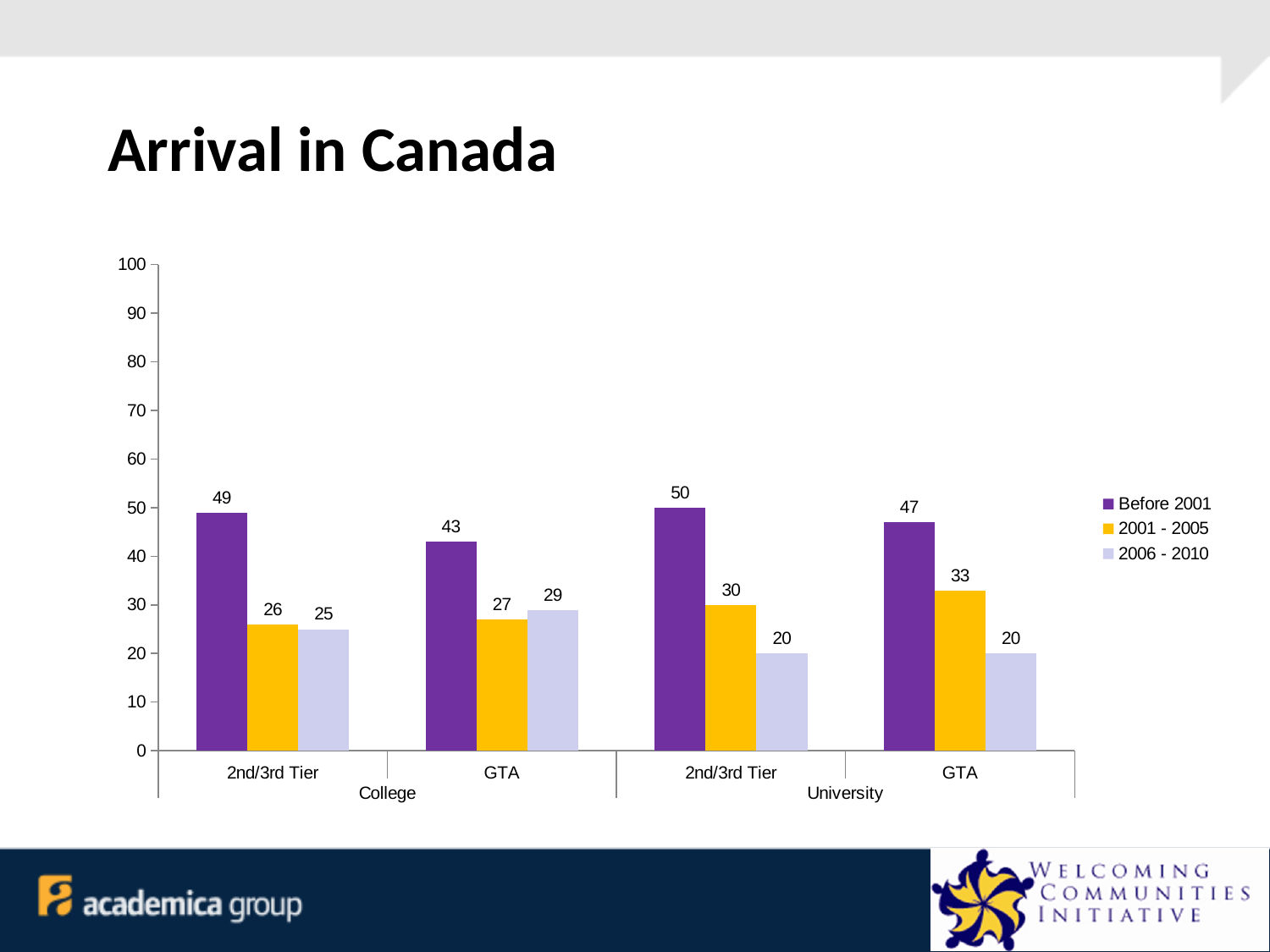
What is the value for Before 2001 in the College 2nd/3rd Tier group? 49 What is the difference between the Before 2001 and 2006 - 2010 values in the University 2nd/3rd Tier group? 30 Which group has the highest Before 2001 value? University 2nd/3rd Tier Which group has the lowest 2001 - 2005 value? College 2nd/3rd Tier What is the title of the slide? Arrival in Canada What is the value for 2006 - 2010 in the University GTA group? 20 Which is larger in the College GTA group: the 2001 - 2005 value or the 2006 - 2010 value? 2006 - 2010 How many series does the legend list? 3 Is the Before 2001 value for University GTA greater or less than 40? greater What kind of chart is shown on the slide? Bar chart How many category groups are shown on the x axis? 4 What is the value for 2001 - 2005 in the College GTA group? 27